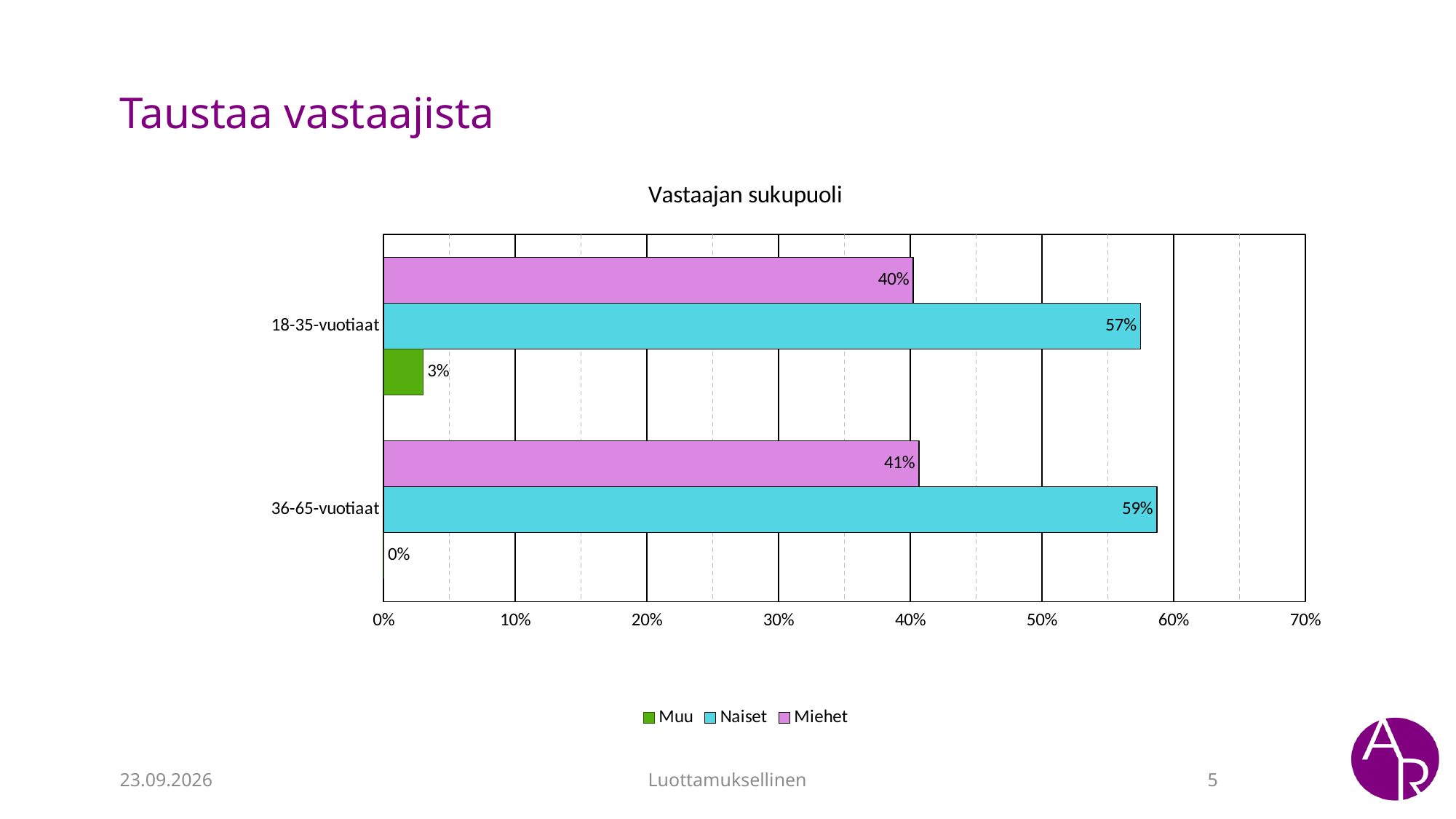
Which series has the lowest value in the 18-35-vuotiaat category? Muu What is the value for Miehet in the 36-65-vuotiaat category? 41% Which is larger: Miehet for 18-35-vuotiaat or Miehet for 36-65-vuotiaat? Miehet for 36-65-vuotiaat What is the title of the chart? Vastaajan sukupuoli How many age categories are shown on the chart? 2 What is the value for Muu in the 18-35-vuotiaat category? 3% Which series has the highest value in the 36-65-vuotiaat category? Naiset What is the difference between the Naiset and Miehet values in the 18-35-vuotiaat category? 17% What is the value for Muu in the 36-65-vuotiaat category? 0% How many series does the legend list? 3 What is the value for Naiset in the 18-35-vuotiaat category? 57% Is the value for Naiset in the 36-65-vuotiaat category greater or less than 50%? greater